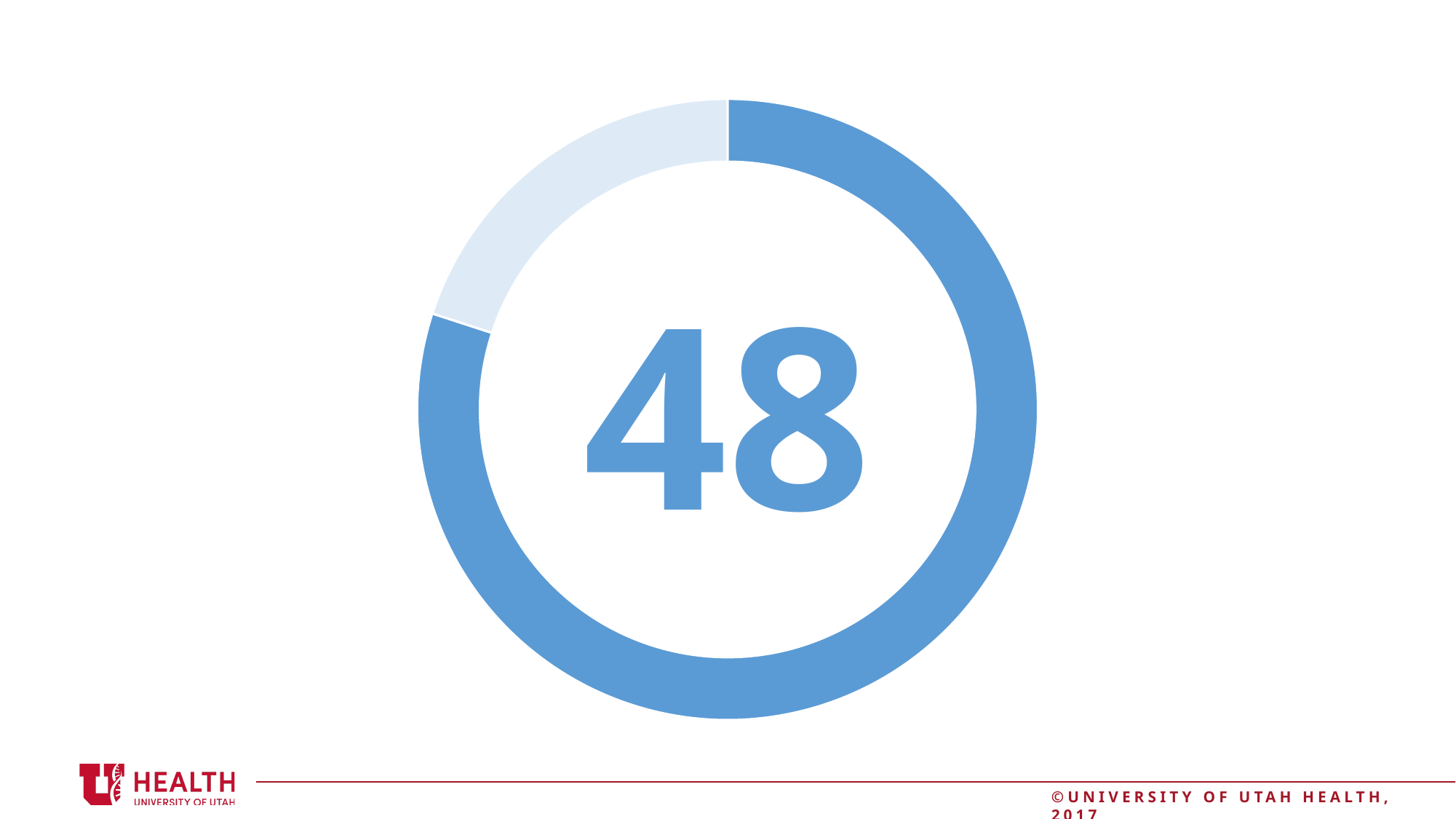
What number is printed in the centre of the donut chart? 48 What kind of chart is shown on the slide? Donut chart What two colours are used for the segments of the donut chart? Dark blue and light blue Which segment of the donut chart is larger, the dark blue one or the light blue one? The dark blue one How many segments does the donut chart have? 2 Is the dark blue segment's share of the donut chart greater or less than 50%? greater Which segment of the donut chart is the smallest? The light blue segment Is the light blue segment's share of the donut chart greater or less than 25%? less